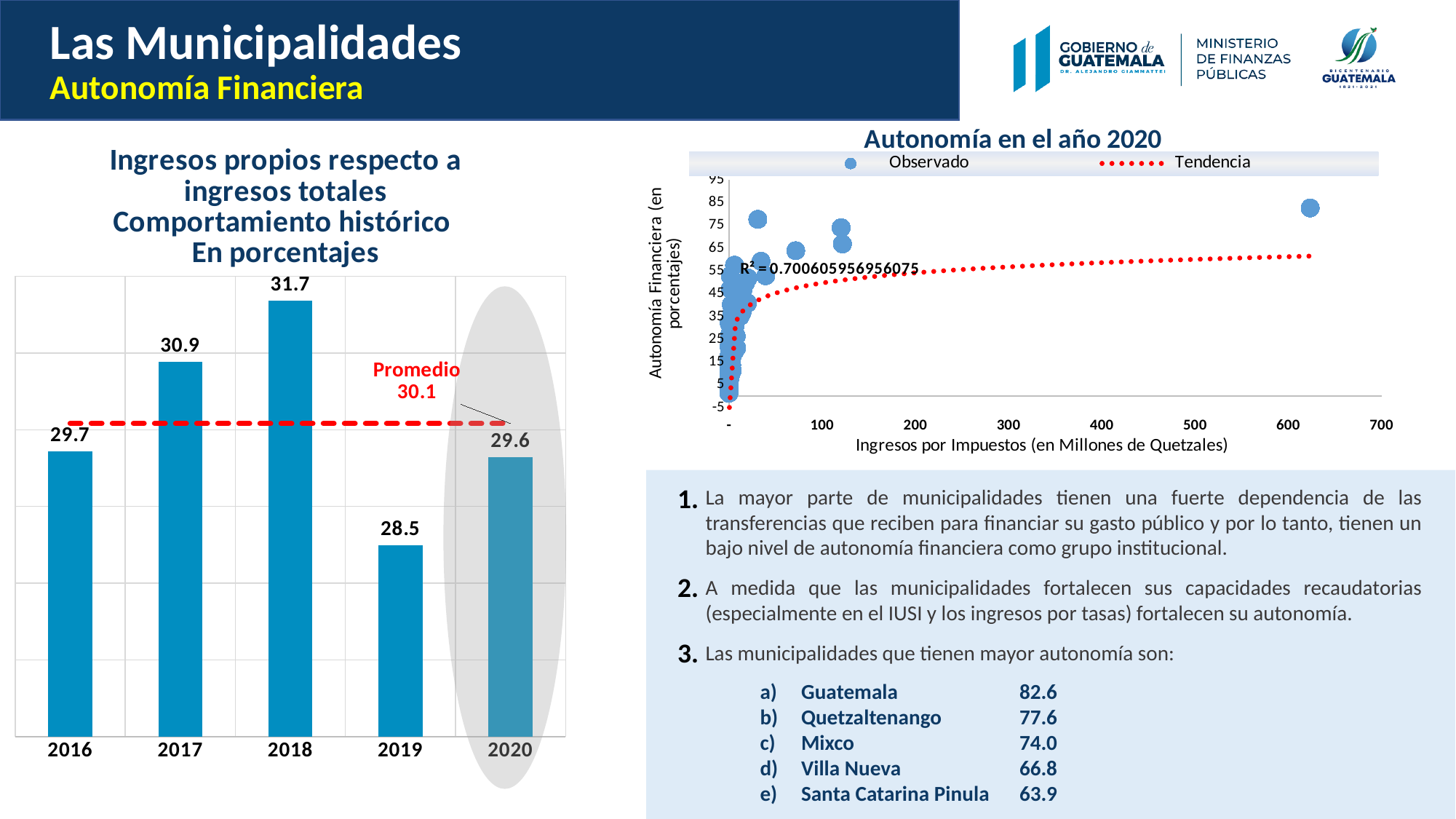
In the bar chart 'Ingresos propios respecto a ingresos totales', what is the value for 2020? 29.6 In the bar chart 'Ingresos propios respecto a ingresos totales', what is the difference between the 2018 and 2019 values? 3.2 In the bar chart 'Ingresos propios respecto a ingresos totales', how many years are shown? 5 In the bar chart 'Ingresos propios respecto a ingresos totales', which year has the lowest value? 2019 What kind of chart is 'Ingresos propios respecto a ingresos totales'? bar chart How many series does the legend of the chart 'Autonomía en el año 2020' list? 2 In the bar chart 'Ingresos propios respecto a ingresos totales', what is the value for 2018? 31.7 What kind of chart is 'Autonomía en el año 2020'? scatter chart In the bar chart 'Ingresos propios respecto a ingresos totales', which is larger, the value for 2016 or the value for 2017? 2017 In the bar chart 'Ingresos propios respecto a ingresos totales', do the values rise or fall from 2018 to 2019? fall In the bar chart 'Ingresos propios respecto a ingresos totales', which year has the highest value? 2018 In the bar chart 'Ingresos propios respecto a ingresos totales', what is the value of the 'Promedio' line? 30.1